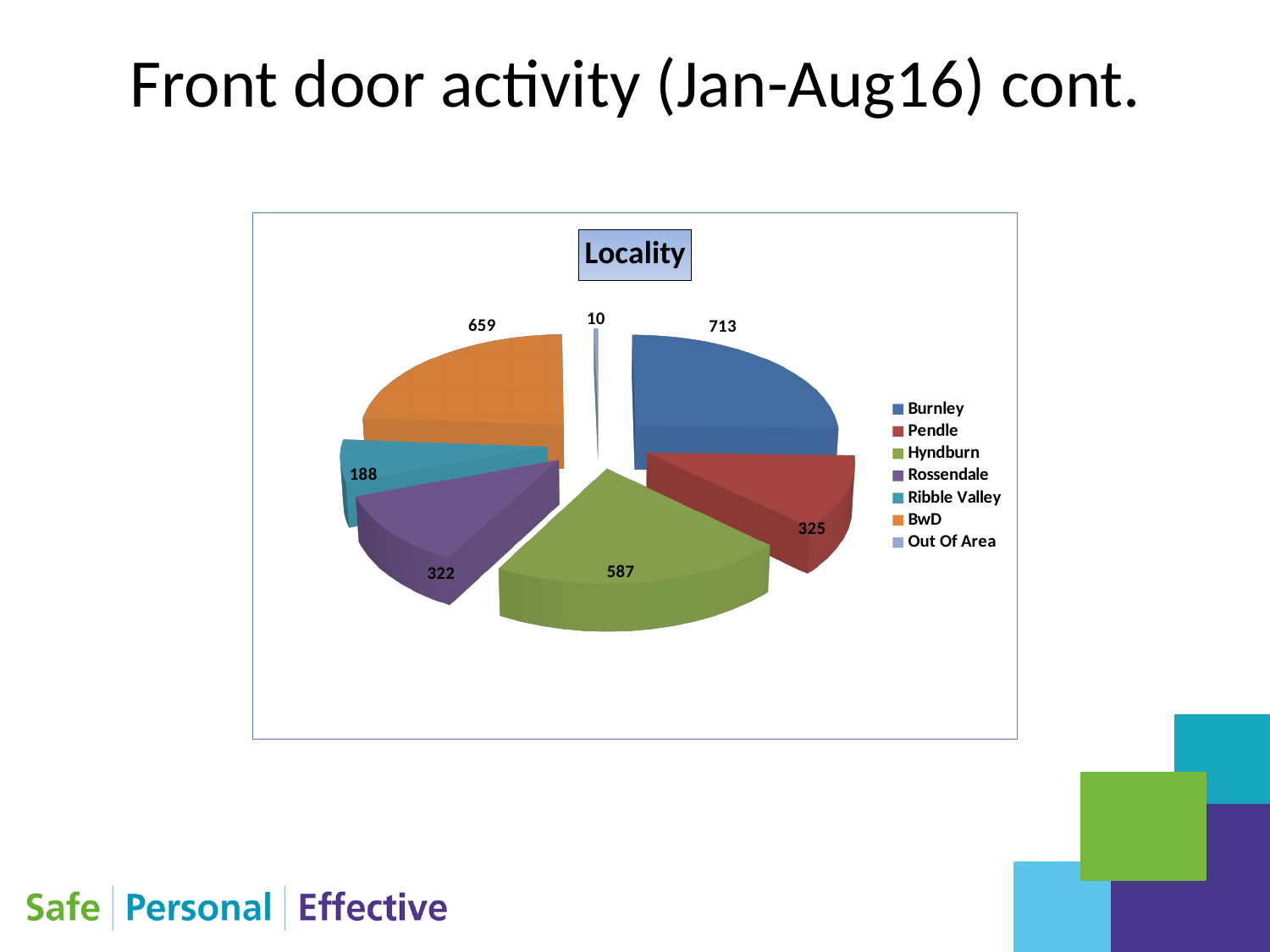
What is the value for Hyndburn in the Locality pie chart? 587 Which locality has the largest slice in the Locality pie chart? Burnley What is the value for Ribble Valley in the Locality pie chart? 188 What is the difference between the values for Hyndburn and Pendle in the Locality pie chart? 262 What is the title of the chart on the slide? Locality Which is larger in the Locality pie chart, the value for BwD or the value for Hyndburn? BwD Which locality has the smallest slice in the Locality pie chart? Out Of Area What is the value for Out Of Area in the Locality pie chart? 10 What kind of chart is shown on the slide? Pie chart How many localities are shown in the Locality pie chart? 7 What is the value for Burnley in the Locality pie chart? 713 What is the difference between the values for Burnley and BwD in the Locality pie chart? 54